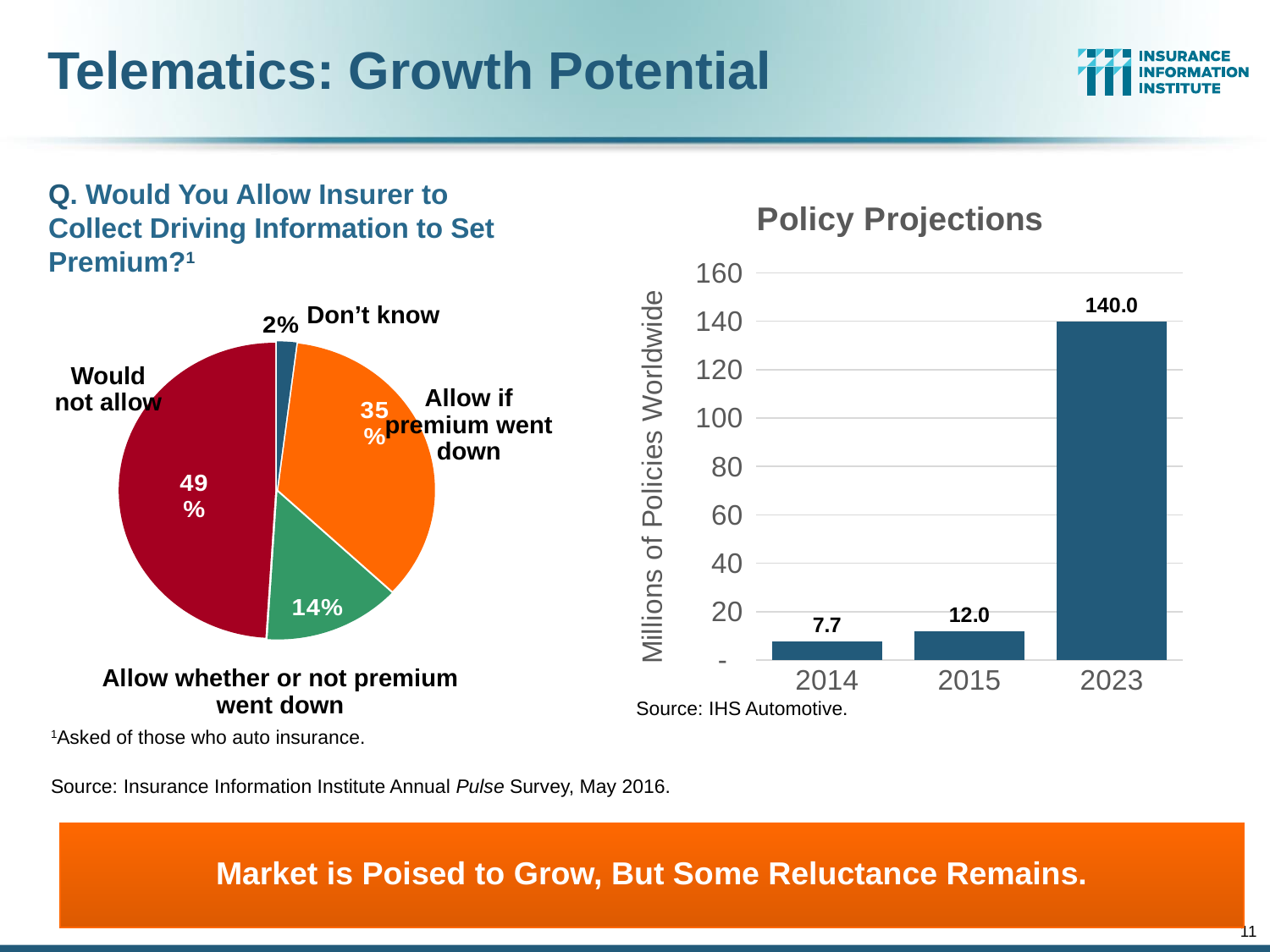
In the Policy Projections chart, what is the value for 2023? 140.0 In the Policy Projections chart, what is the difference between the 2015 and 2014 values? 4.3 In the pie chart on the left, what percentage would allow it if the premium went down? 35% In the pie chart on the left, what percentage answered 'Don't know'? 2% In the pie chart on the left, which response has the largest slice? Would not allow In the pie chart on the left, how many slices are there? 4 In the Policy Projections chart, what is the value for 2014? 7.7 In the pie chart on the left, which response has the smallest slice? Don't know What kind of chart is the Policy Projections chart? Bar chart In the Policy Projections chart, do the values rise or fall from 2014 to 2023? Rise In the pie chart on the left, what is the difference in percentage points between 'Would not allow' and 'Allow whether or not premium went down'? 35 In the pie chart on the left, what share of respondents would not allow the insurer to collect driving information? 49%